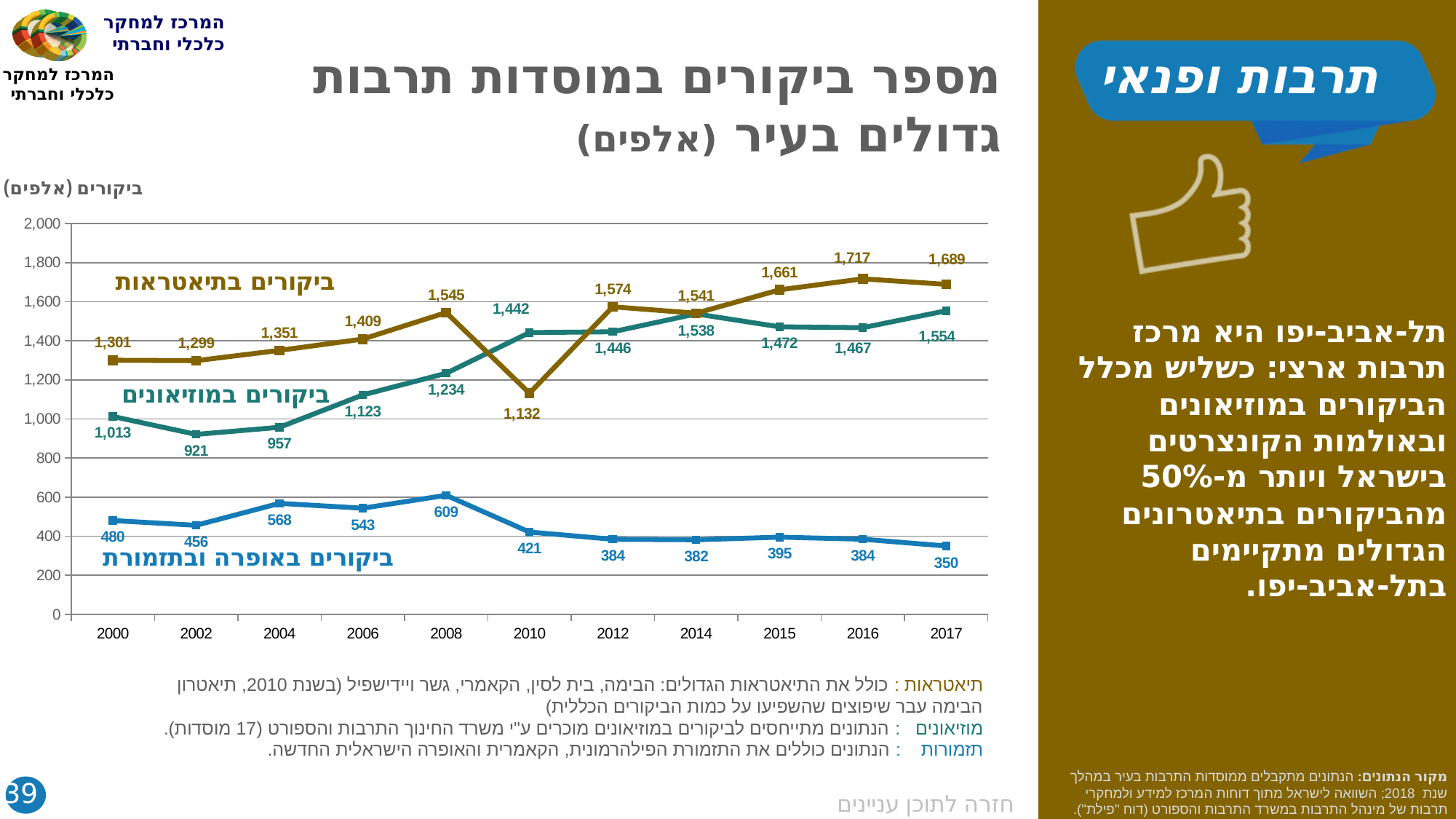
What was the number of museum visits (ביקורים במוזיאונים) in 2010? 1,442 In which year were theatre visits (ביקורים בתיאטראות) at their lowest? 2010 What is the label of the y axis? ביקורים (אלפים) What was the number of theatre visits (ביקורים בתיאטראות) in 2016? 1,717 What is the difference between theatre visits and museum visits in 2017? 135 What was the number of opera and orchestra visits (ביקורים באופרה ובתזמורת) in 2008? 609 How many years are plotted along the x axis? 11 What type of chart is shown on the slide? line chart In which year were museum visits (ביקורים במוזיאונים) at their highest? 2017 How many series are plotted on the chart? 3 Did opera and orchestra visits (ביקורים באופרה ובתזמורת) rise or fall between 2008 and 2017? fall Which was larger in 2010: theatre visits or museum visits? museum visits